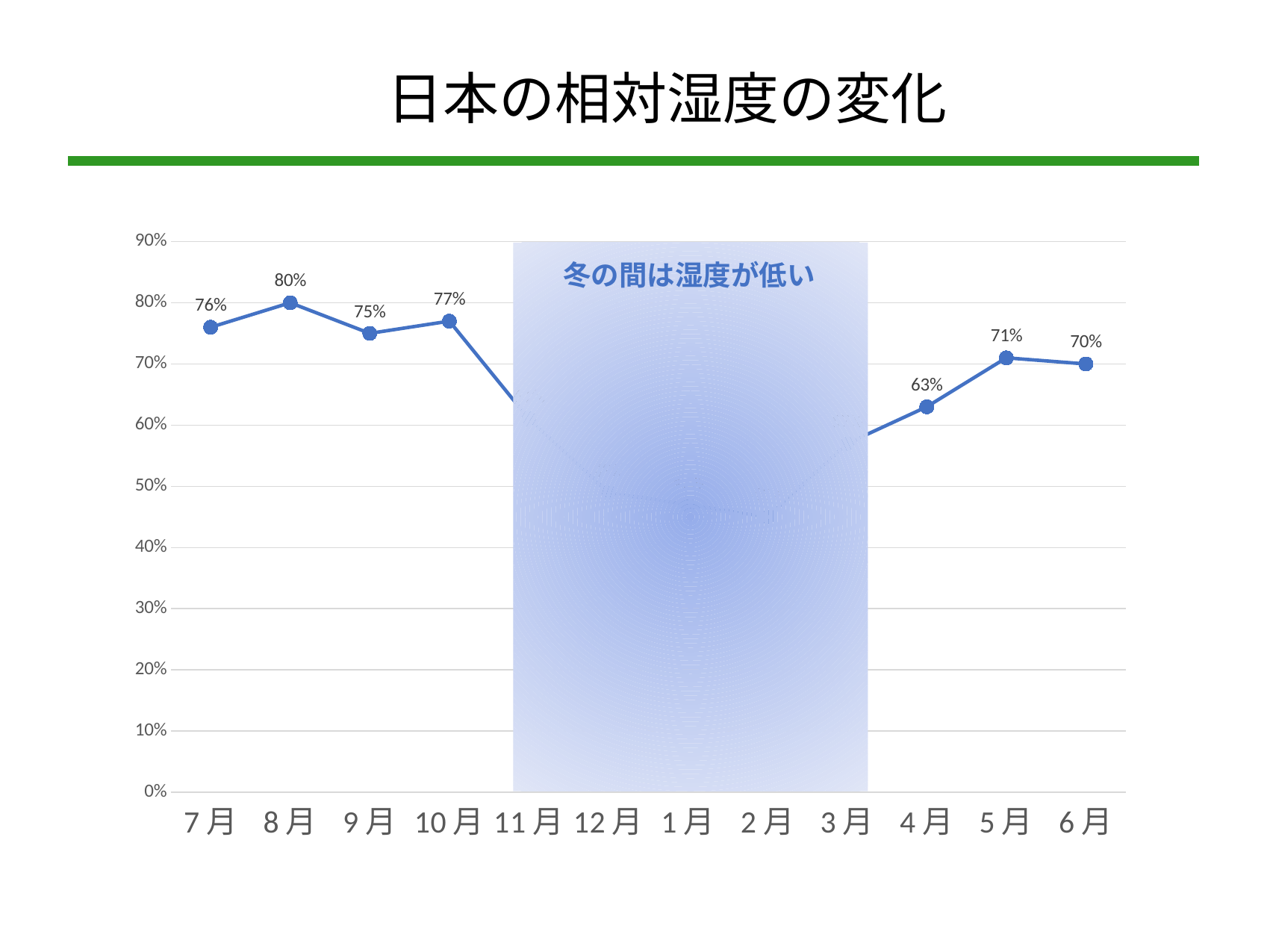
Which is larger, the value for 7月 or the value for 9月? 7月 What is the relative humidity value shown for 6月? 70% How many months are shown on the x axis? 12 What is the relative humidity value shown for 8月? 80% What is the difference between the values for 8月 and 4月? 17% What kind of chart is shown on the slide? Line chart Does the value rise or fall from 4月 to 5月? Rise What is the relative humidity value shown for 4月? 63% Among the labeled data points, which month has the highest relative humidity? 8月 What is the relative humidity value shown for 10月? 77% Among the labeled data points, which month has the lowest relative humidity? 4月 What text is written in the shaded winter area of the chart? 冬の間は湿度が低い